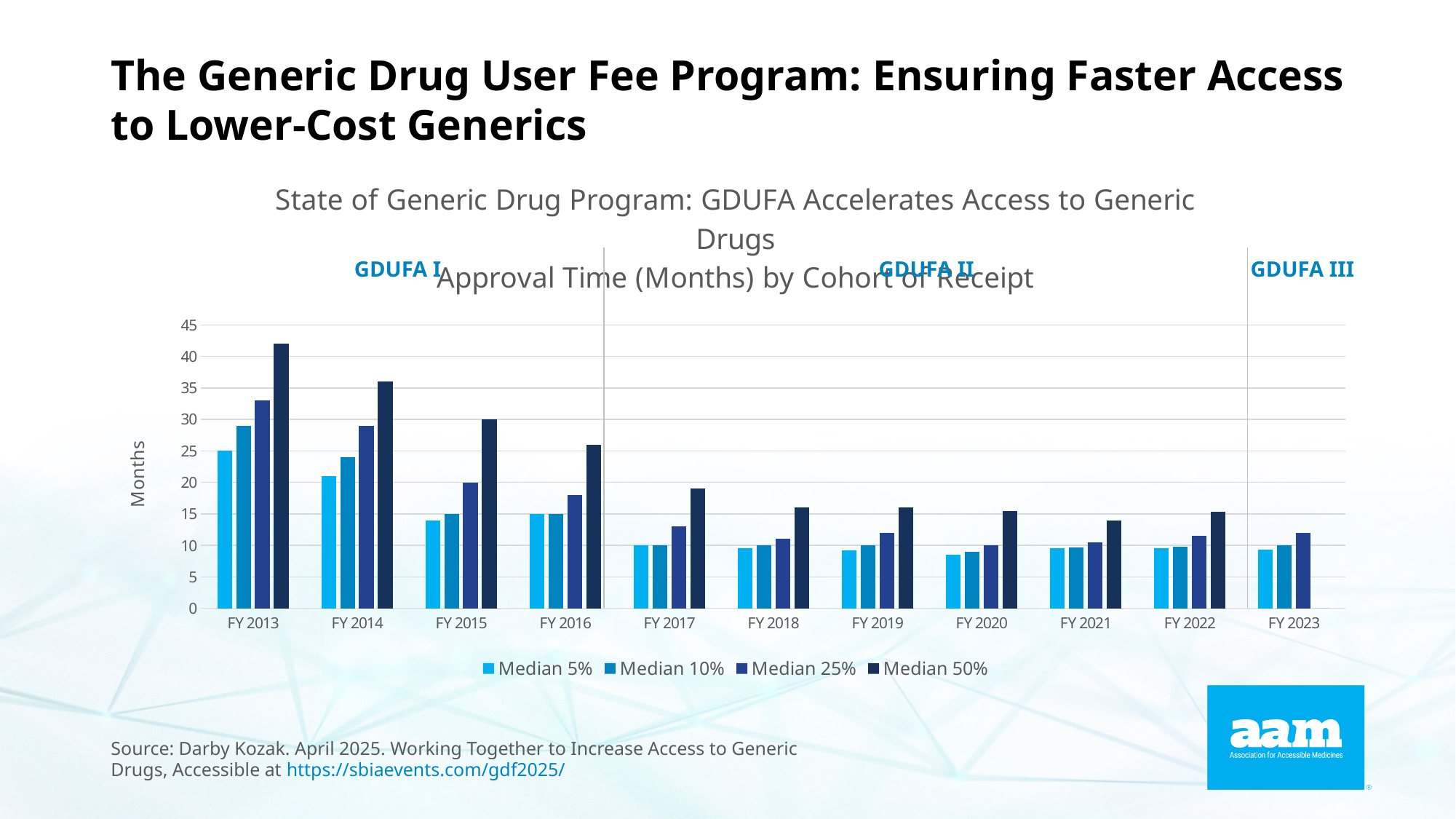
Which GDUFA period label appears above FY 2023? GDUFA III What is the label on the y axis? Months Is the Median 50% value for FY 2014 greater or less than 35? greater Is the Median 50% value for FY 2013 greater or less than 40? greater Which is larger, the Median 50% value for FY 2013 or for FY 2023? FY 2013 Is the Median 5% value for FY 2020 greater or less than 10? less What kind of chart is shown on the slide? bar chart Which fiscal year has the highest Median 50% approval time? FY 2013 Does the Median 50% approval time generally rise or fall from FY 2013 to FY 2023? fall How many fiscal years are shown on the x axis? 11 How many series does the legend list? 4